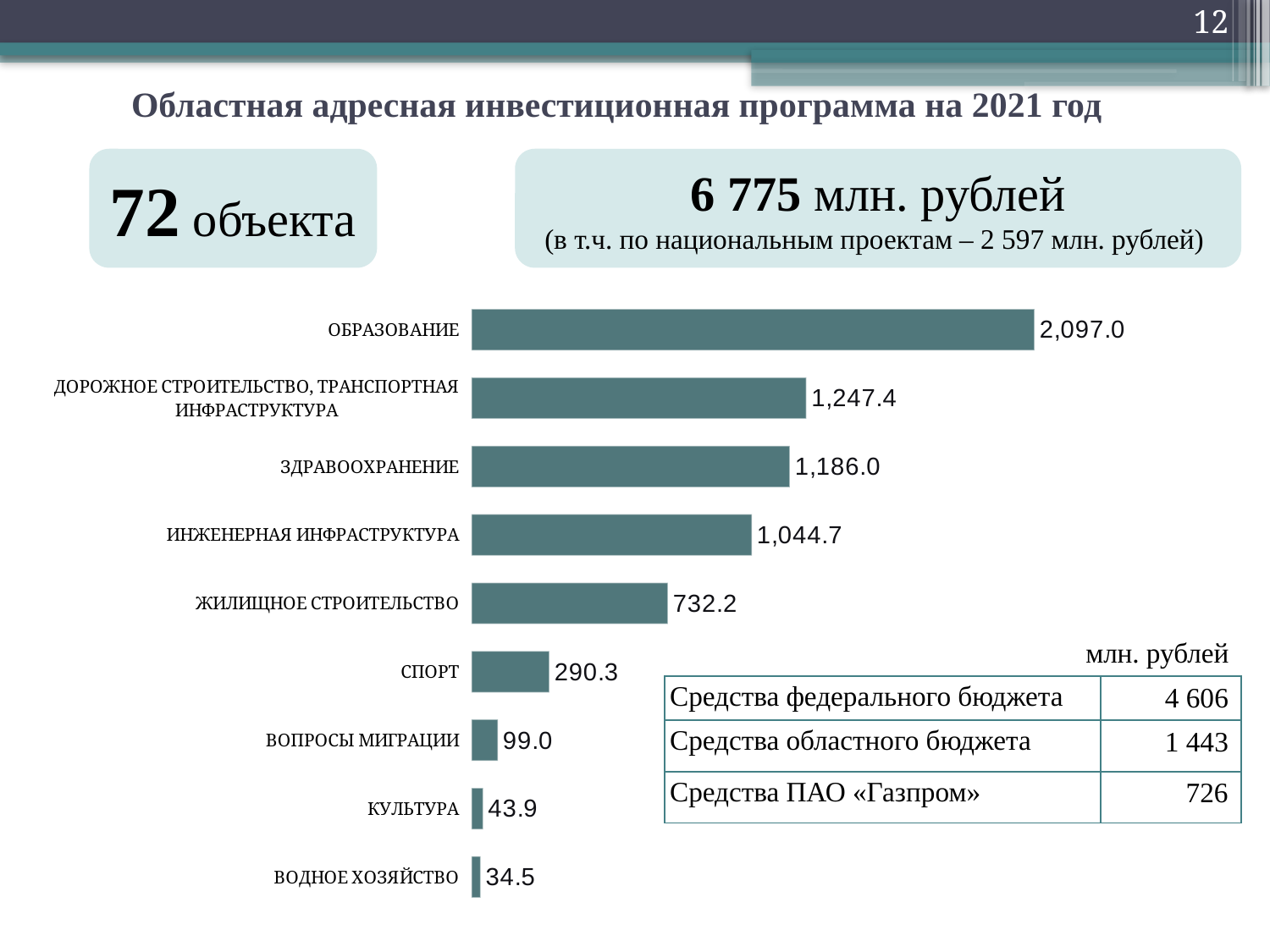
What is the value for ЖИЛИЩНОЕ СТРОИТЕЛЬСТВО? 732.2 Which category has the lowest value? ВОДНОЕ ХОЗЯЙСТВО What is the difference between the values for ОБРАЗОВАНИЕ and ЖИЛИЩНОЕ СТРОИТЕЛЬСТВО? 1,364.8 What is the value for ОБРАЗОВАНИЕ? 2,097.0 What kind of chart is shown on the slide? bar chart What is the value for КУЛЬТУРА? 43.9 Which is larger, the value for ИНЖЕНЕРНАЯ ИНФРАСТРУКТУРА or the value for ЖИЛИЩНОЕ СТРОИТЕЛЬСТВО? ИНЖЕНЕРНАЯ ИНФРАСТРУКТУРА How many categories are shown in the bar chart? 9 What is the difference between the values for СПОРТ and ВОПРОСЫ МИГРАЦИИ? 191.3 What is the value for ЗДРАВООХРАНЕНИЕ? 1,186.0 What is the value for ДОРОЖНОЕ СТРОИТЕЛЬСТВО, ТРАНСПОРТНАЯ ИНФРАСТРУКТУРА? 1,247.4 Which category has the highest value? ОБРАЗОВАНИЕ